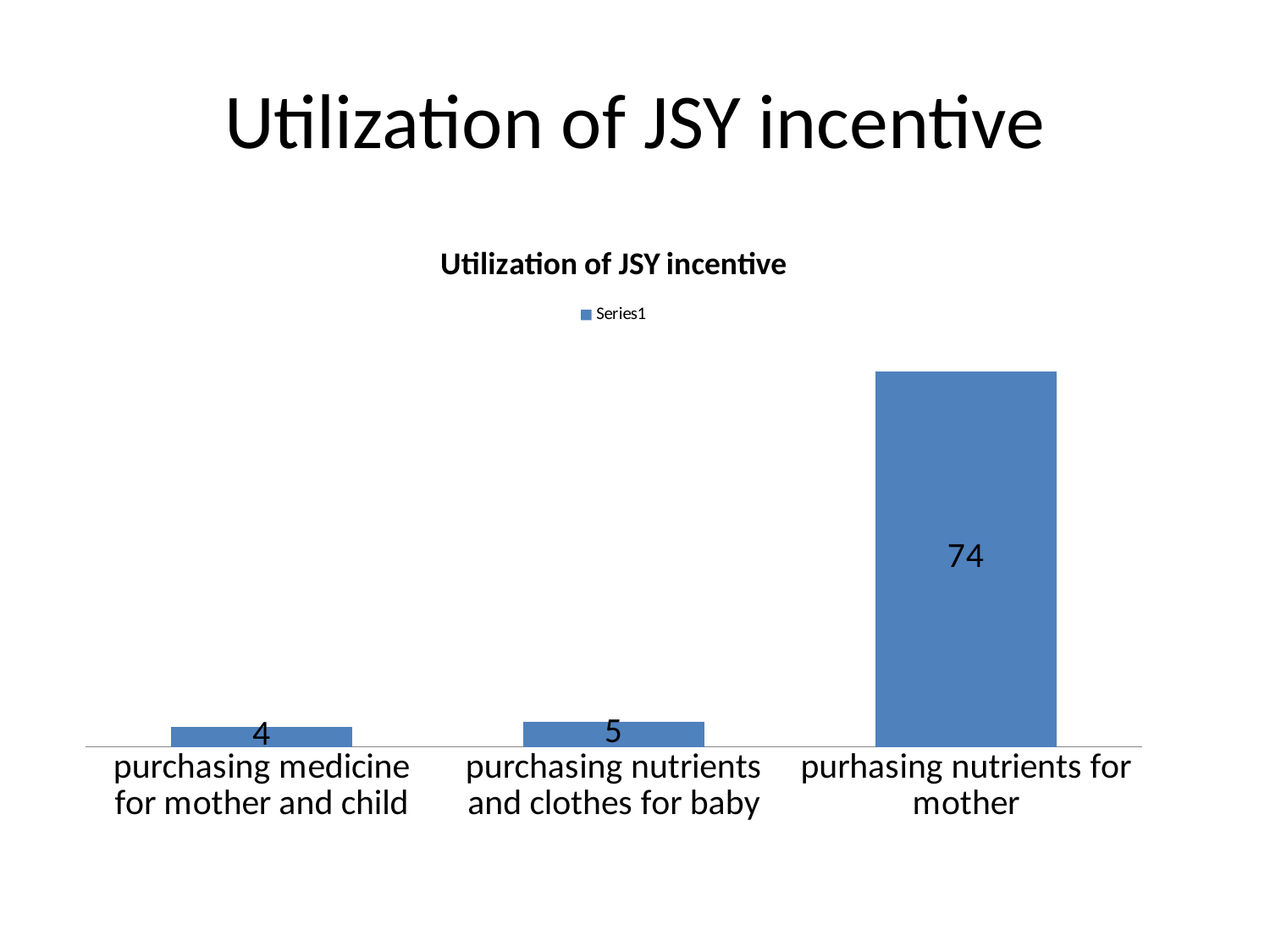
Which is larger: the value for 'purchasing medicine for mother and child' or the value for 'purhasing nutrients for mother'? purhasing nutrients for mother What kind of chart is shown on the slide? bar chart Which category has the highest value? purhasing nutrients for mother How many categories are shown in the chart? 3 What is the difference between the values for 'purhasing nutrients for mother' and 'purchasing nutrients and clothes for baby'? 69 What is the value for 'purhasing nutrients for mother'? 74 What is the title of the chart? Utilization of JSY incentive What is the value for 'purchasing nutrients and clothes for baby'? 5 Which category has the lowest value? purchasing medicine for mother and child How many series does the legend list? 1 What is the difference between the values for 'purchasing nutrients and clothes for baby' and 'purchasing medicine for mother and child'? 1 What is the value for 'purchasing medicine for mother and child'? 4